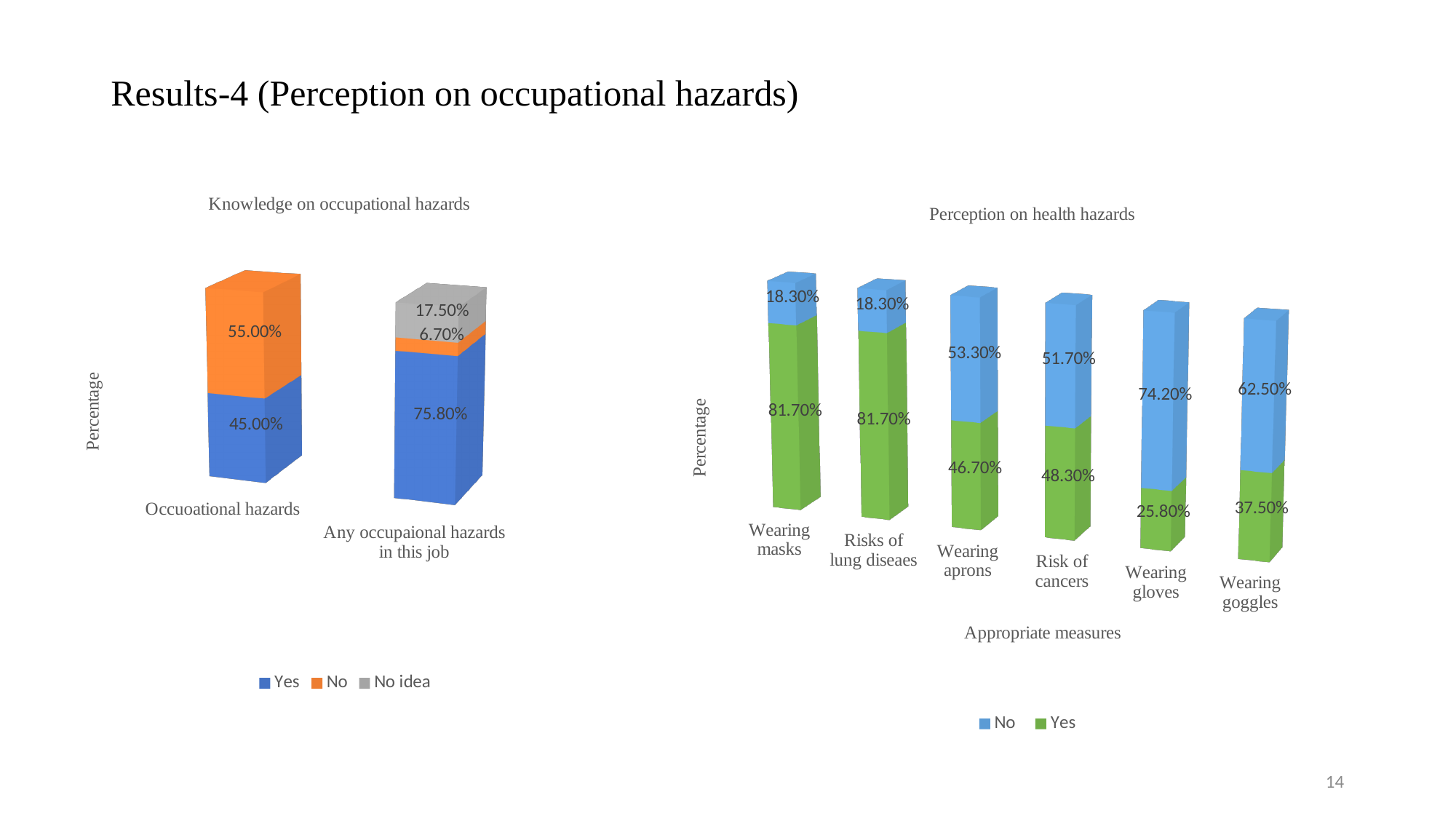
In the 'Perception on health hazards' chart, what is the 'Yes' value for 'Wearing gloves'? 25.80% In the 'Perception on health hazards' chart, which category has the lowest 'Yes' value? Wearing gloves In the 'Knowledge on occupational hazards' chart, what is the 'No idea' value for 'Any occupaional hazards in this job'? 17.50% In the 'Knowledge on occupational hazards' chart, how many series does the legend list? 3 What type of chart is the 'Perception on health hazards' chart? Stacked bar chart How many categories are shown in the 'Perception on health hazards' chart? 6 In the 'Knowledge on occupational hazards' chart, what is the difference between the 'No' values for 'Occuoational hazards' and 'Any occupaional hazards in this job'? 48.30% In the 'Perception on health hazards' chart, what is the difference between the 'No' values for 'Wearing gloves' and 'Wearing goggles'? 11.70% In the 'Perception on health hazards' chart, what is the 'No' value for 'Wearing aprons'? 53.30% In the 'Knowledge on occupational hazards' chart, what is the 'Yes' value for 'Occuoational hazards'? 45.00% In the 'Perception on health hazards' chart, which category has the highest 'No' value? Wearing gloves In the 'Perception on health hazards' chart, is the 'Yes' value larger for 'Wearing goggles' or 'Risk of cancers'? Risk of cancers